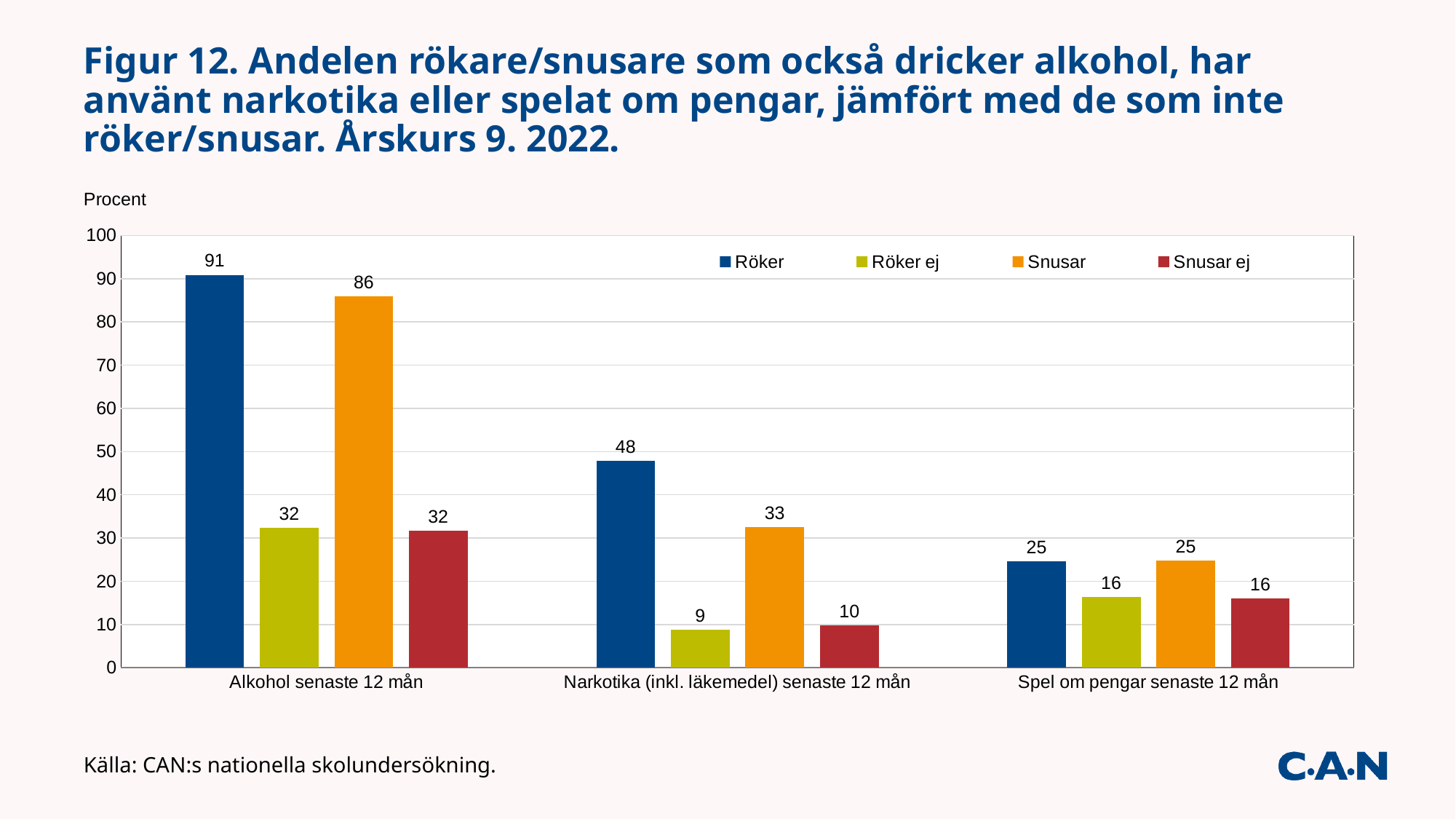
Is the value for Snusar in the Alkohol senaste 12 mån category greater or less than 80? greater What kind of chart is shown on the slide? Bar chart What is the value for Röker in the Alkohol senaste 12 mån category? 91 What is the label on the y axis? Procent How many series does the legend list? 4 Which series has the highest value in the Alkohol senaste 12 mån category? Röker What is the value for Snusar in the Narkotika (inkl. läkemedel) senaste 12 mån category? 33 What is the value for Röker ej in the Spel om pengar senaste 12 mån category? 16 How many categories are shown on the x axis? 3 What is the difference between the Röker and Röker ej values in the Narkotika (inkl. läkemedel) senaste 12 mån category? 39 Which series has the lowest value in the Narkotika (inkl. läkemedel) senaste 12 mån category? Röker ej Which is larger in the Alkohol senaste 12 mån category: the Röker value or the Snusar value? Röker